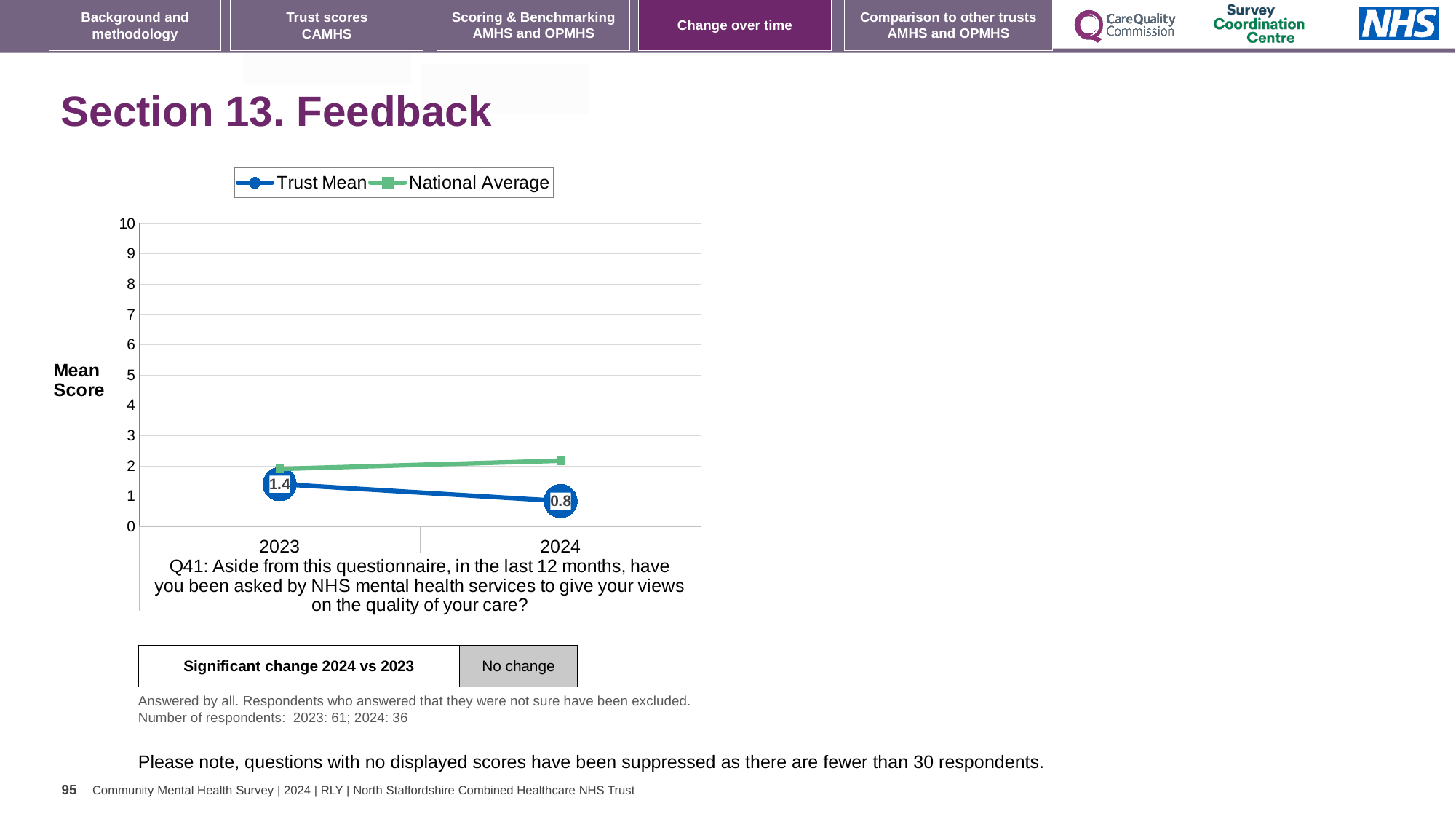
Which year has the higher Trust Mean, 2023 or 2024? 2023 What is the Trust Mean value for 2024? 0.8 What kind of chart is shown on the slide? line chart Does the Trust Mean rise or fall from 2023 to 2024? fall What is the difference between the Trust Mean in 2023 and in 2024? 0.6 How many years are plotted on the x axis? 2 Is the National Average value for 2023 greater or less than 1? greater Is the National Average value for 2024 greater or less than 3? less How many series does the legend list? 2 In 2024, which is larger: the Trust Mean or the National Average? National Average What is the Trust Mean value for 2023? 1.4 Which year has the lowest Trust Mean? 2024